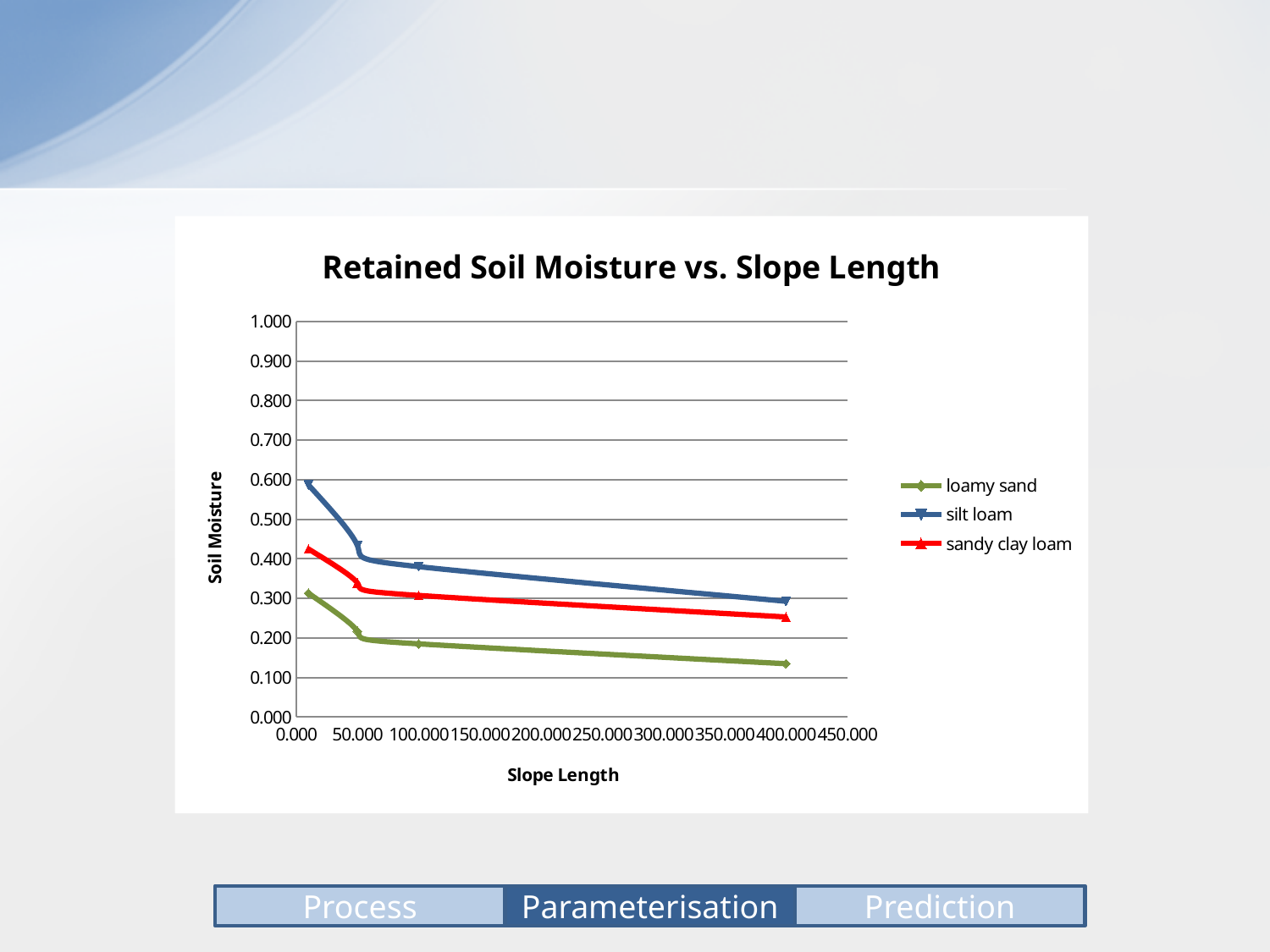
Is the soil moisture for loamy sand at a slope length of 400 greater or less than 0.200? less Is the soil moisture for silt loam at its first (shortest slope length) point greater or less than 0.500? greater How many series does the legend list? 3 At a slope length of 400, which has the larger soil moisture: silt loam or loamy sand? silt loam Which series has the lowest soil moisture across the plotted slope lengths? loamy sand Does the soil moisture for silt loam rise or fall as slope length increases? fall What kind of chart is shown on the slide? line chart What colour is the line for sandy clay loam? red Which series has the highest soil moisture across the plotted slope lengths? silt loam Is the soil moisture for sandy clay loam at a slope length of 100 greater or less than 0.400? less What is the title of the chart? Retained Soil Moisture vs. Slope Length